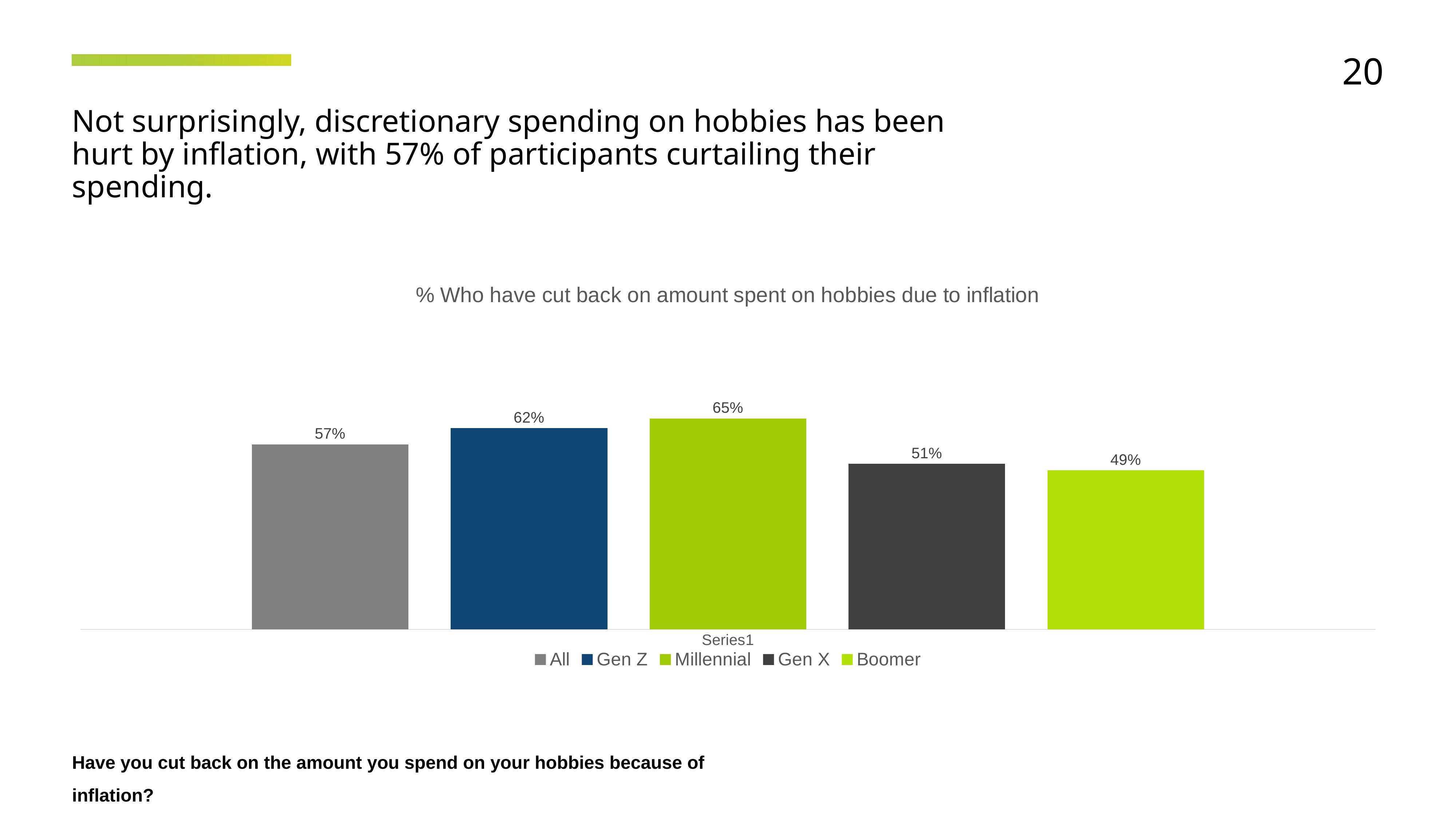
What is the value shown for Gen X in the chart? 51% Which group has the lowest percentage who have cut back on hobby spending due to inflation? Boomer What is the value shown for Boomer in the chart? 49% What is the title of the chart? % Who have cut back on amount spent on hobbies due to inflation How many bars are plotted in the chart? 5 What percentage of Gen Z respondents have cut back on the amount spent on hobbies due to inflation? 62% Which group has the highest percentage who have cut back on hobby spending due to inflation? Millennial What is the difference in percentage points between Gen Z and the All group? 5 What is the difference in percentage points between Millennial and Boomer? 16 Which is larger, the value for Gen Z or the value for Gen X? Gen Z What type of chart is shown on the slide? Bar chart How many entries does the legend list? 5